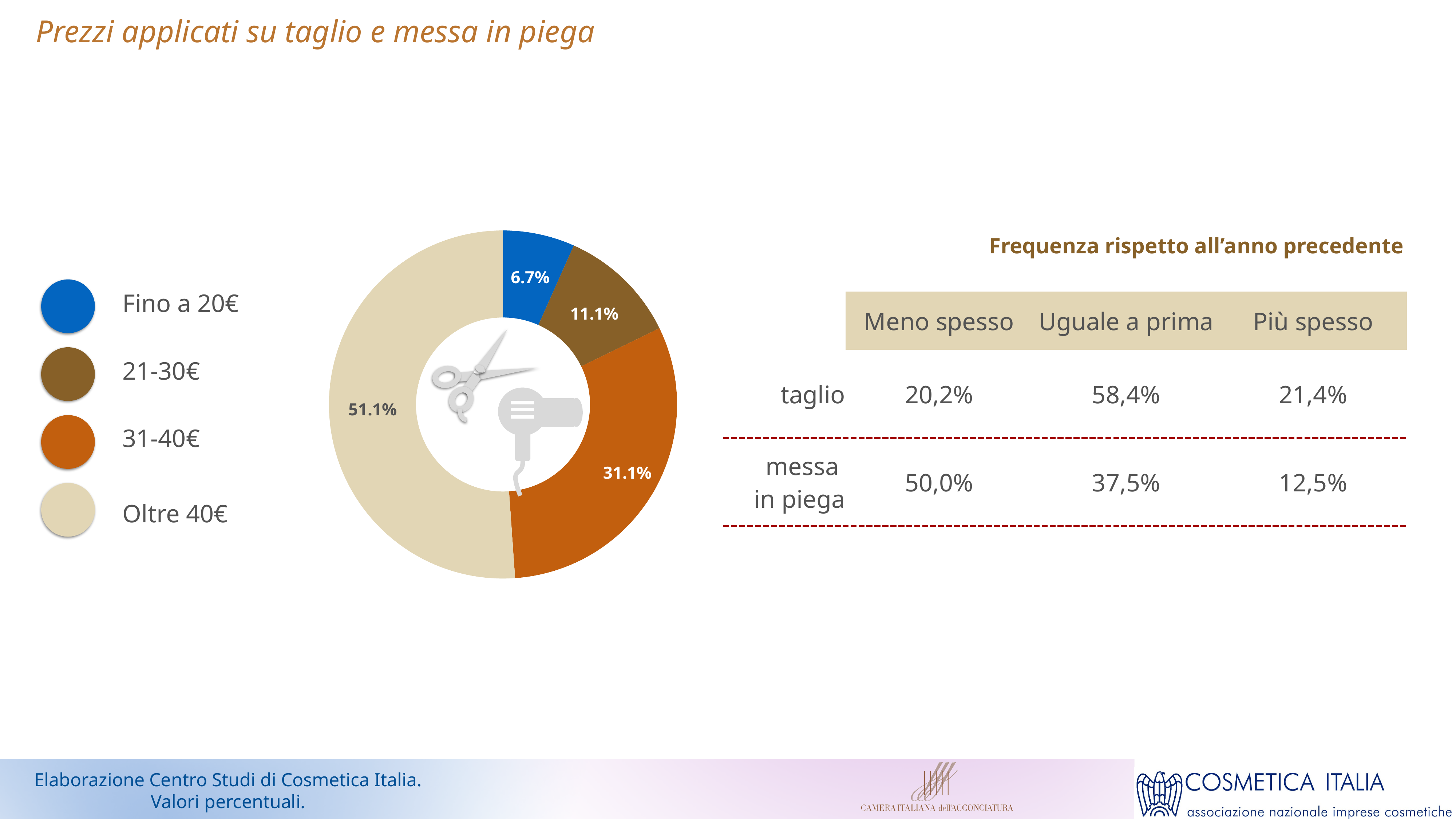
What colour represents 'Fino a 20€' in the pie chart legend? Blue What percentage of the pie chart corresponds to '21-30€'? 11.1% What kind of chart is shown on the slide? Pie chart (donut) What percentage of the pie chart corresponds to 'Fino a 20€'? 6.7% What percentage of the pie chart corresponds to 'Oltre 40€'? 51.1% How many price bands (slices) does the pie chart show? 4 What percentage of the pie chart corresponds to '31-40€'? 31.1% Which price band has the largest slice in the pie chart? Oltre 40€ What is the difference in percentage points between the 'Oltre 40€' slice and the '31-40€' slice? 20 percentage points Which price band has the smallest slice in the pie chart? Fino a 20€ What is the title of the slide containing the pie chart? Prezzi applicati su taglio e messa in piega Which slice is larger in the pie chart: '21-30€' or '31-40€'? 31-40€